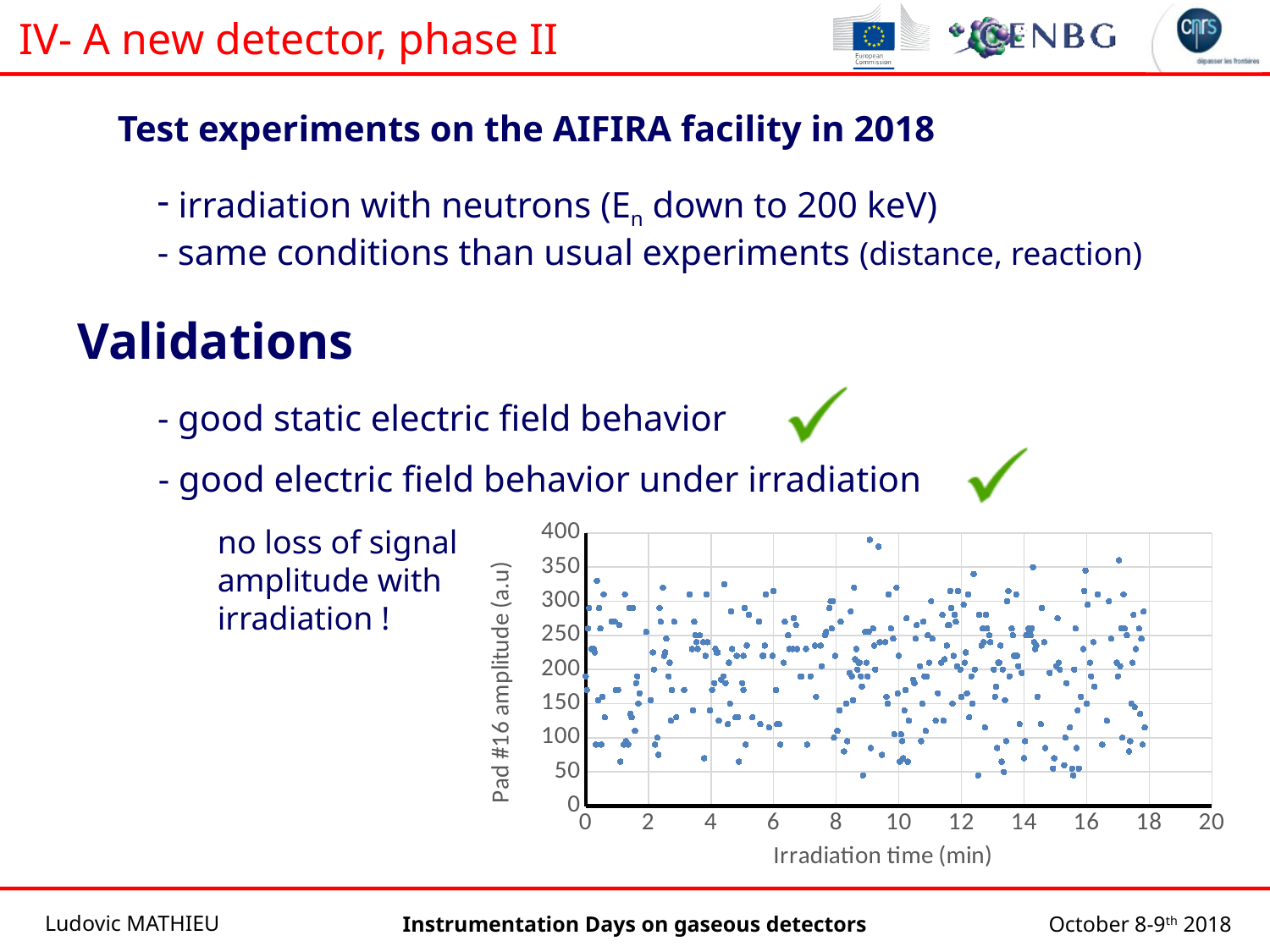
What is the maximum value shown on the x axis of the chart? 20 What is the maximum value shown on the y axis of the chart? 400 Is the latest irradiation time with plotted points greater or less than 16 min? greater What is the label of the y axis of the chart? Pad #16 amplitude (a.u) Do the plotted amplitude values rise, fall, or stay roughly constant as irradiation time increases? stay roughly constant Is the highest plotted amplitude value greater or less than 350? greater Are all plotted amplitude values less than 400? yes What kind of chart is shown on the slide? scatter chart What is the label of the x axis of the chart? Irradiation time (min)